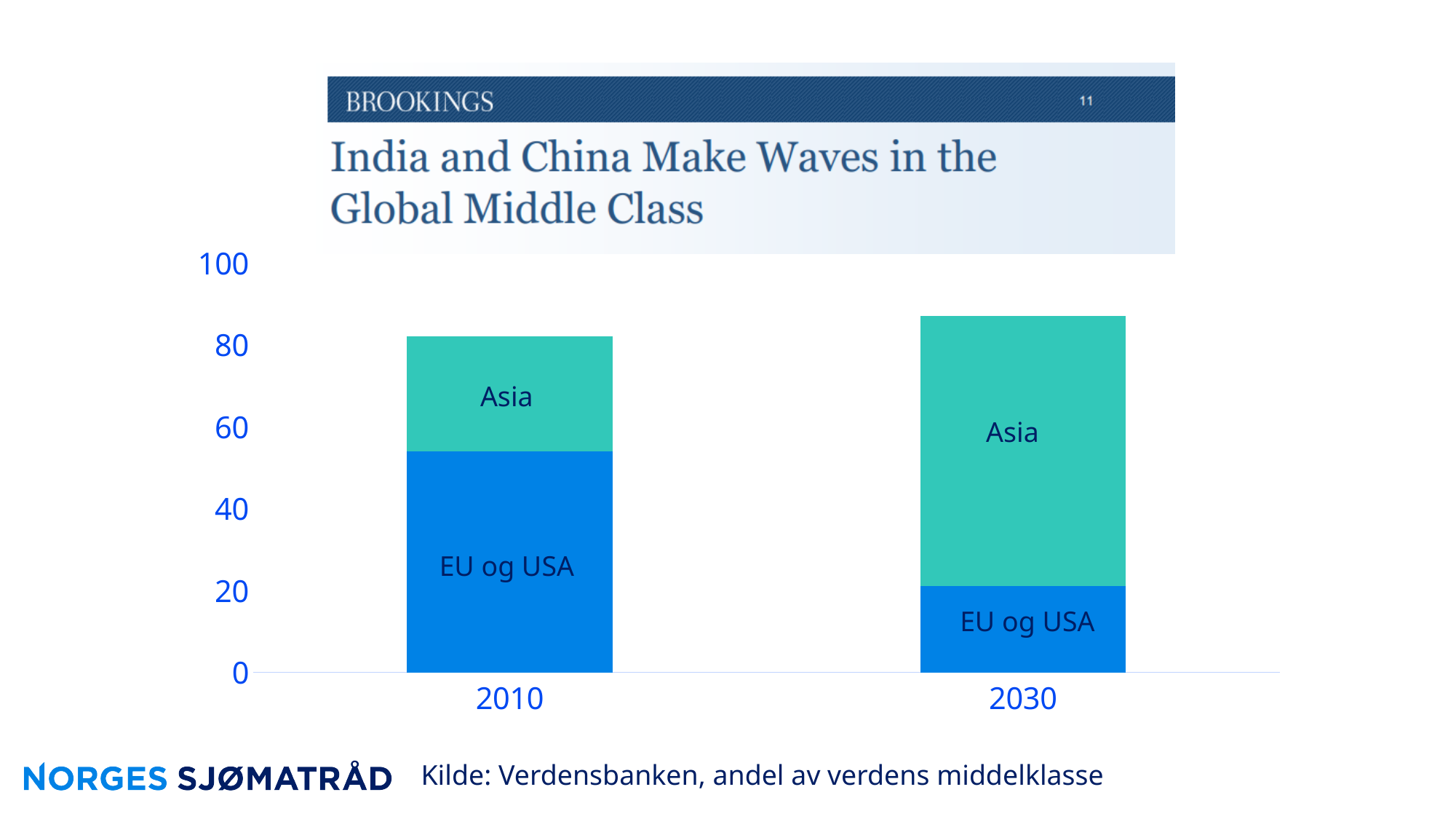
Is the value for EU og USA in 2030 greater or less than 40? less Which year has the larger Asia segment, 2010 or 2030? 2030 Is the total height of the 2030 stacked bar greater or less than 80? greater In the 2030 bar, which segment is larger, Asia or EU og USA? Asia How many series are stacked in each bar of the chart? 2 How many years (categories) are shown on the x axis of the chart? 2 Is the total height of the 2010 stacked bar greater or less than 100? less Which year has the larger EU og USA segment, 2010 or 2030? 2010 Which two years are shown on the x axis of the chart? 2010 and 2030 What kind of chart is shown on the slide? Stacked bar chart Does the EU og USA share rise or fall from 2010 to 2030? Fall